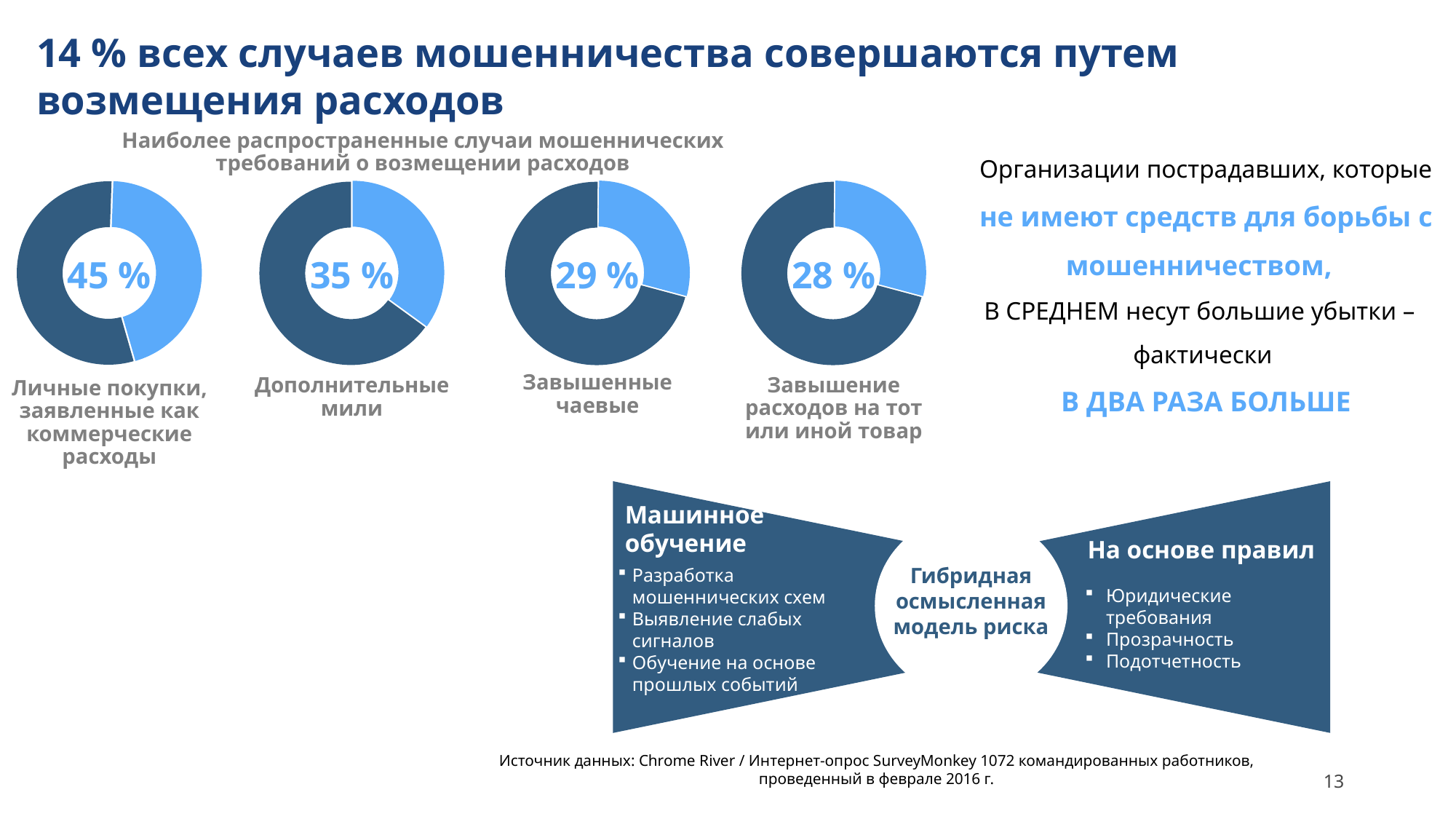
Which category among the four donut charts has the lowest value? Завышение расходов на тот или иной товар What is the value shown in the donut chart for «Завышенные чаевые»? 29 % How many donut charts are shown on the slide? 4 What is the difference between the values for «Личные покупки, заявленные как коммерческие расходы» and «Дополнительные мили»? 10 % What type of chart is used to show the fraud reimbursement cases? Donut (pie) chart What is the value shown in the donut chart for «Завышение расходов на тот или иной товар»? 28 % What is the value shown in the donut chart for «Дополнительные мили»? 35 % What is the value shown in the donut chart for «Личные покупки, заявленные как коммерческие расходы»? 45 % What is the title above the group of donut charts? Наиболее распространенные случаи мошеннических требований о возмещении расходов Which is larger: the value for «Дополнительные мили» or the value for «Завышенные чаевые»? Дополнительные мили What is the difference between the values for «Завышенные чаевые» and «Завышение расходов на тот или иной товар»? 1 % Which category among the four donut charts has the highest value? Личные покупки, заявленные как коммерческие расходы